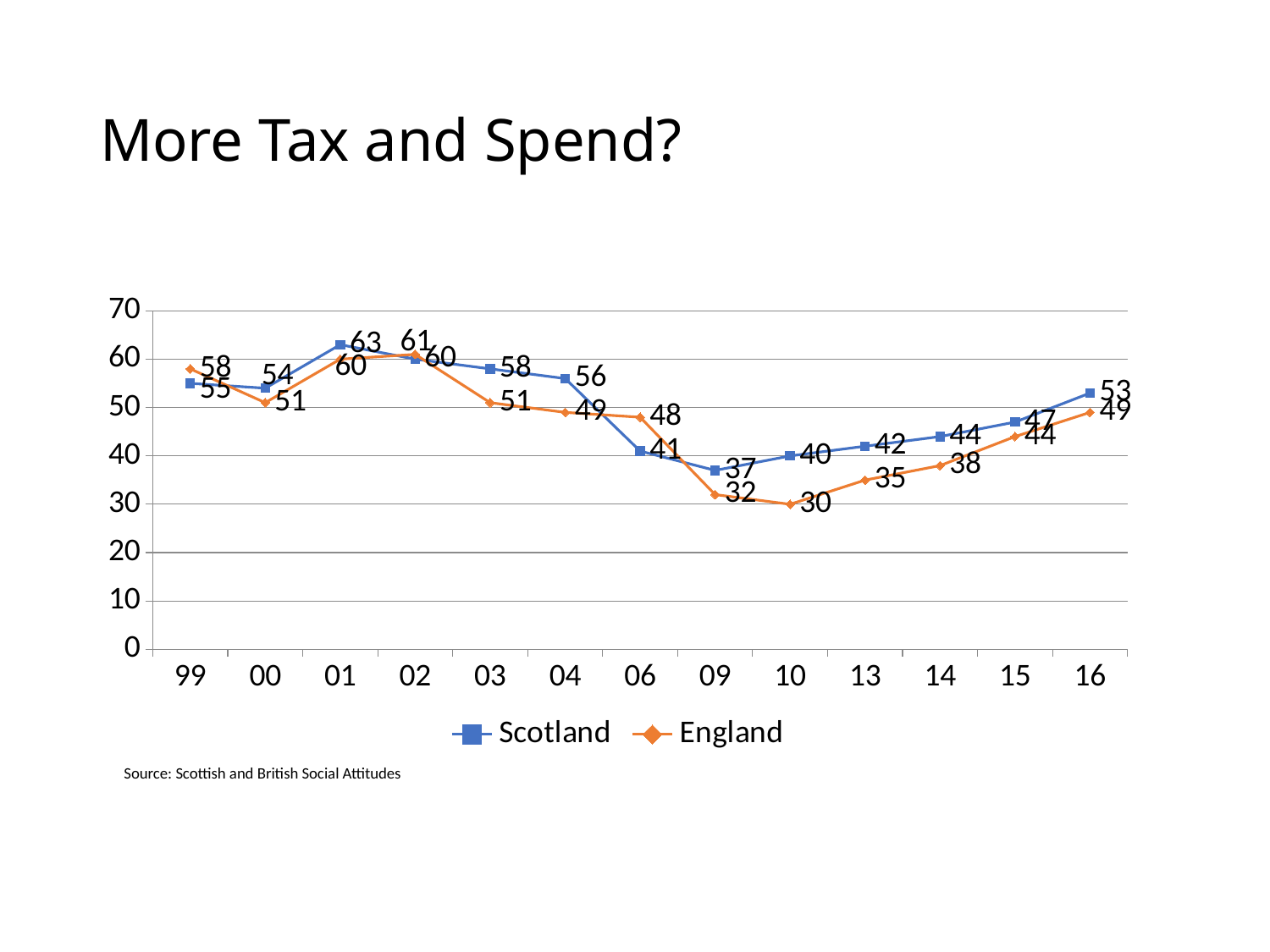
What is the title of the chart? More Tax and Spend? In 99, which series has the higher value, Scotland or England? England What is the difference between England and Scotland in 06? 7 In which year is the England series at its lowest? 10 How many series does the legend list? 2 What kind of chart is shown on the slide? Line chart In which year is the Scotland series at its highest? 01 How many years are plotted along the x axis? 13 What is the value for Scotland in 09? 37 From 10 to 16, does the Scotland series rise or fall? Rise What is the value for England in 16? 49 What is the value for England in 10? 30